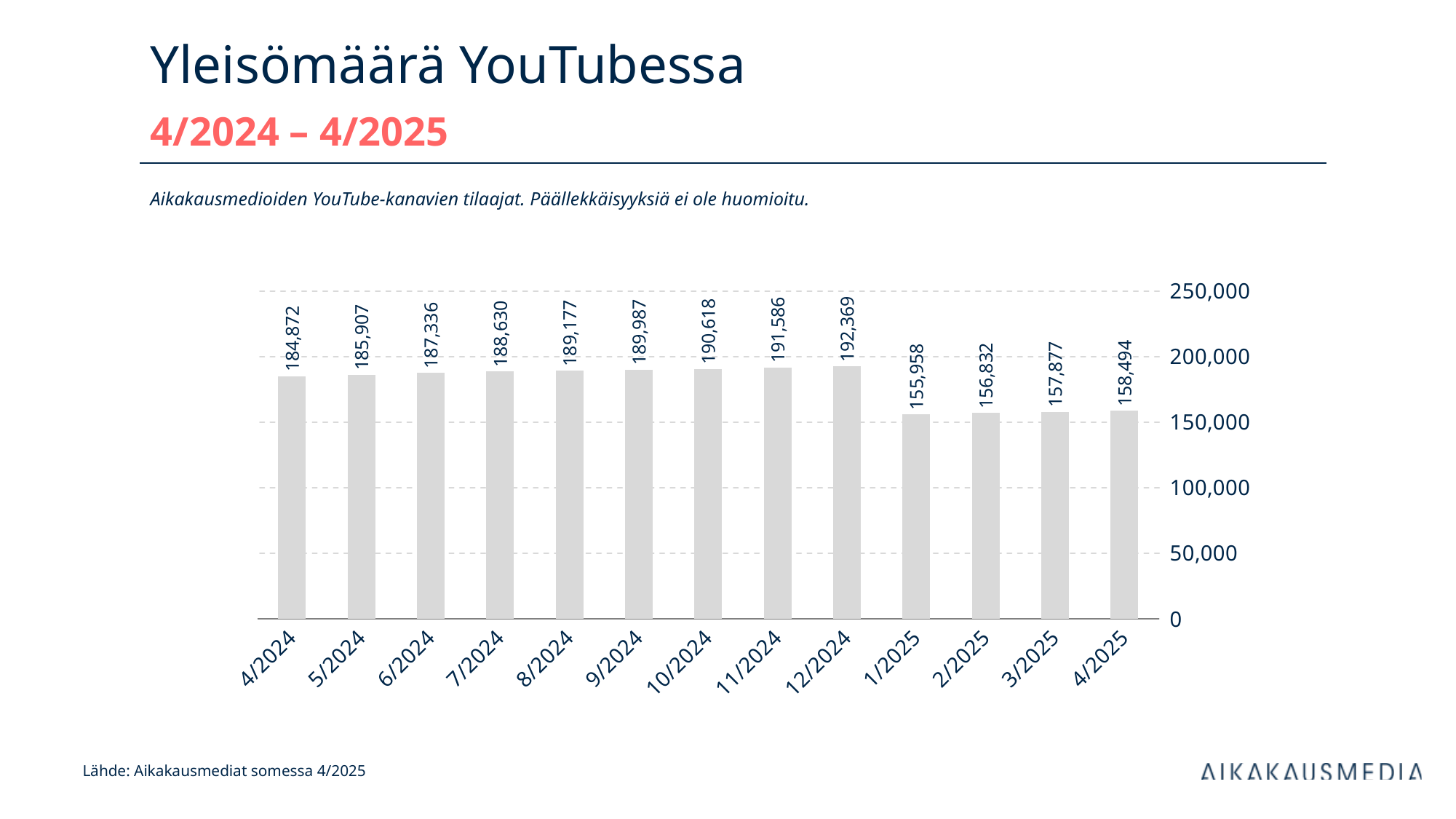
What is the value for 1/2025? 155,958 What kind of chart is shown on the slide? bar chart Which is larger, the value for 9/2024 or the value for 3/2025? 9/2024 What is the difference between the values for 12/2024 and 1/2025? 36,411 How many months are shown on the x axis? 13 What is the value for 12/2024? 192,369 Do the values rise or fall from 4/2024 to 12/2024? rise Which month has the lowest value? 1/2025 Which month has the highest value? 12/2024 Is the value for 2/2025 greater or less than 200,000? less What is the difference between the values for 4/2024 and 4/2025? 26,378 What is the value for 4/2024? 184,872